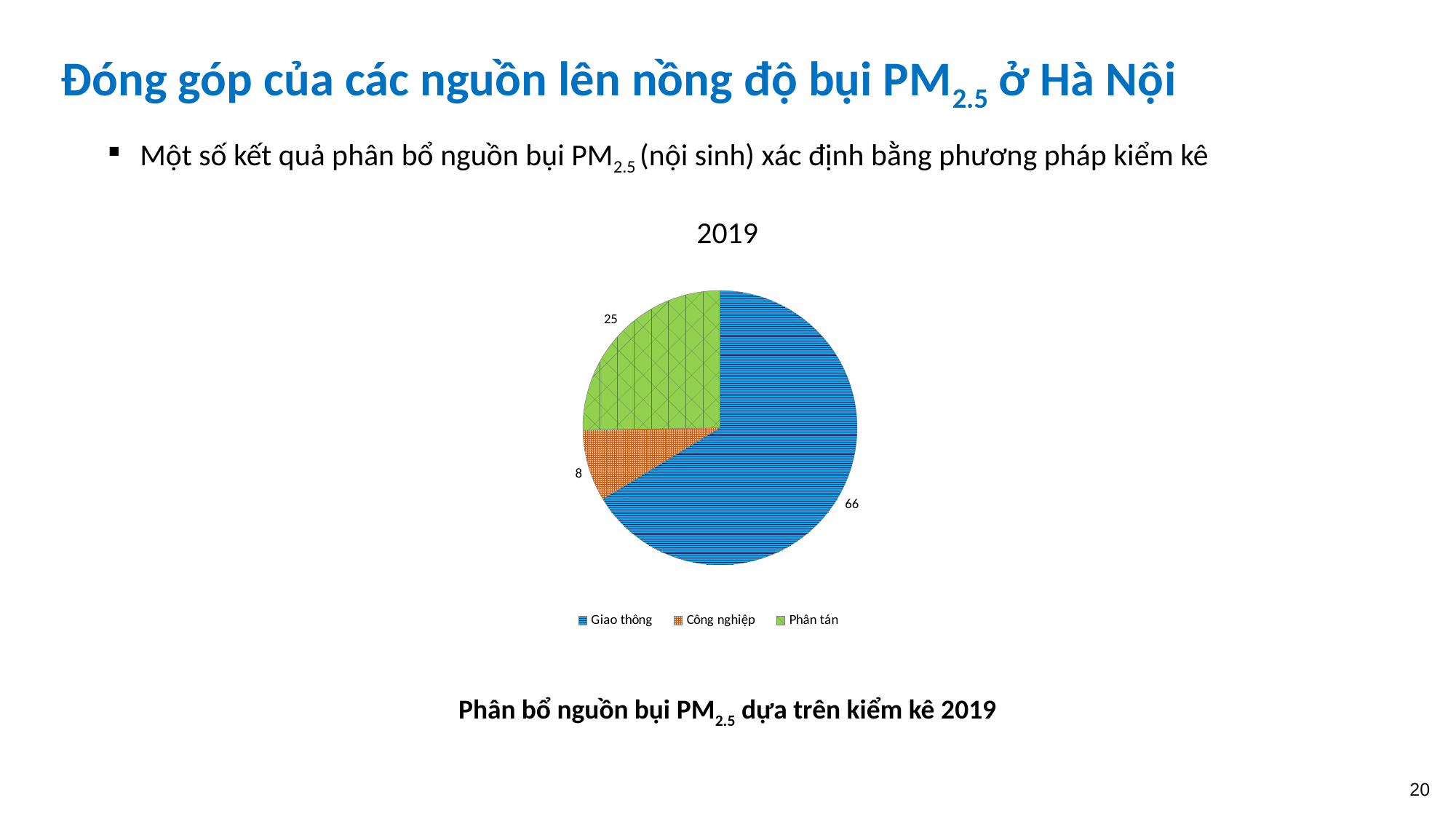
What value is labelled for the Công nghiệp slice? 8 Which category has the largest slice of the pie? Giao thông What is the title shown above the pie chart? 2019 What value is labelled for the Giao thông slice? 66 Which is larger, the value for Phân tán or the value for Công nghiệp? Phân tán How many entries does the legend list? 3 What is the difference between the values for Giao thông and Phân tán? 41 What kind of chart is shown on the slide? Pie chart What is the difference between the values for Phân tán and Công nghiệp? 17 Which category has the smallest slice of the pie? Công nghiệp What value is labelled for the Phân tán slice? 25 How many slices does the pie chart have? 3